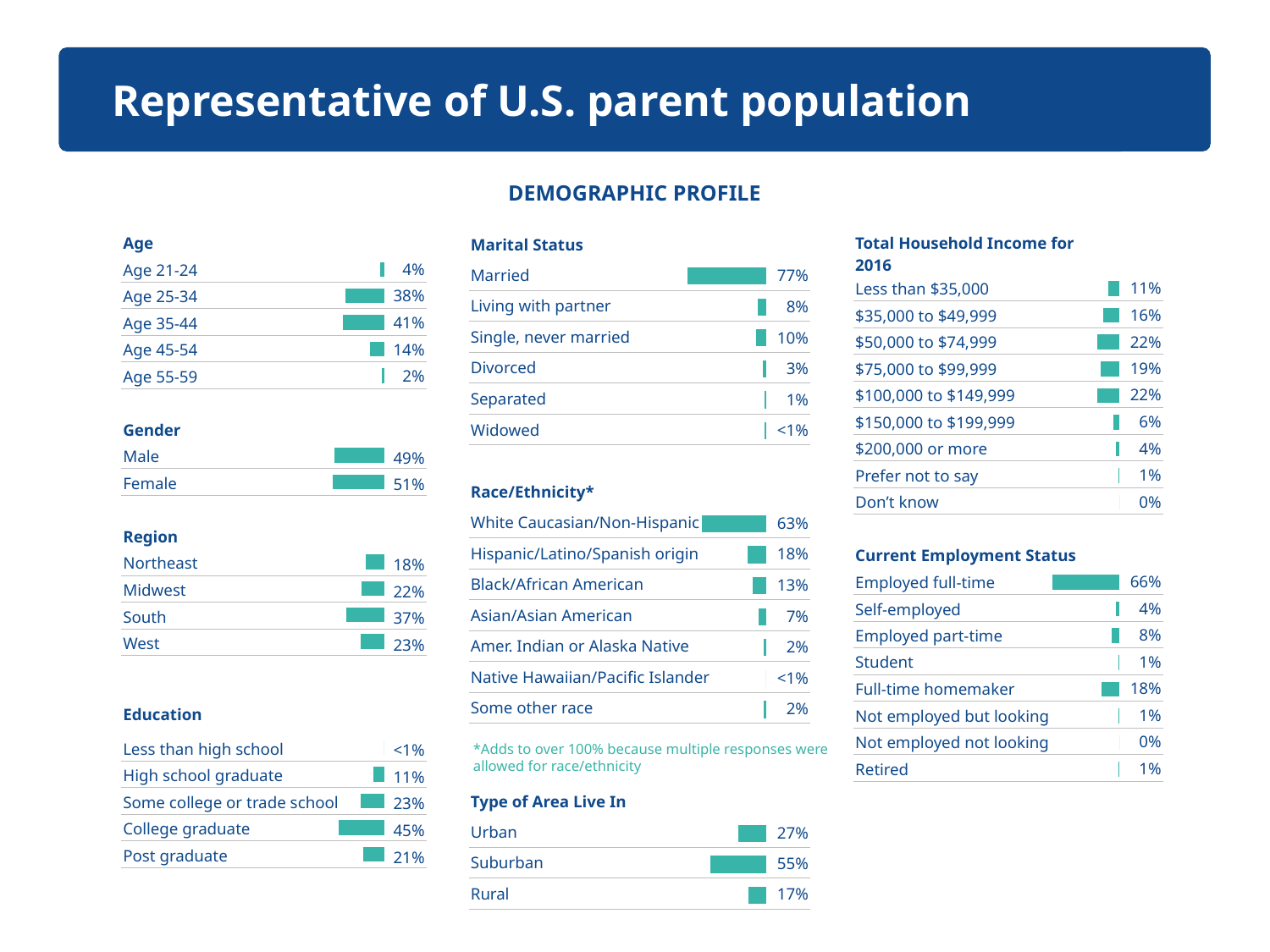
In the Type of Area Live In chart, which category has the lowest value? Rural In the Race/Ethnicity chart, what is the value for Hispanic/Latino/Spanish origin? 18% In the Current Employment Status chart, what is the value for Full-time homemaker? 18% How many categories are shown in the Total Household Income for 2016 chart? 9 In the Gender chart, what is the value for Female? 51% What kind of chart is used for the Total Household Income for 2016 data? Bar chart In the Marital Status chart, which category has the highest value? Married In the Age chart, what percentage of respondents are Age 35-44? 41% In the Total Household Income for 2016 chart, what is the difference between $50,000 to $74,999 and $150,000 to $199,999? 16% In the Region chart, what is the difference between South and Northeast? 19% What is the title of the section containing all the charts on the slide? DEMOGRAPHIC PROFILE In the Education chart, which is larger: College graduate or Some college or trade school? College graduate